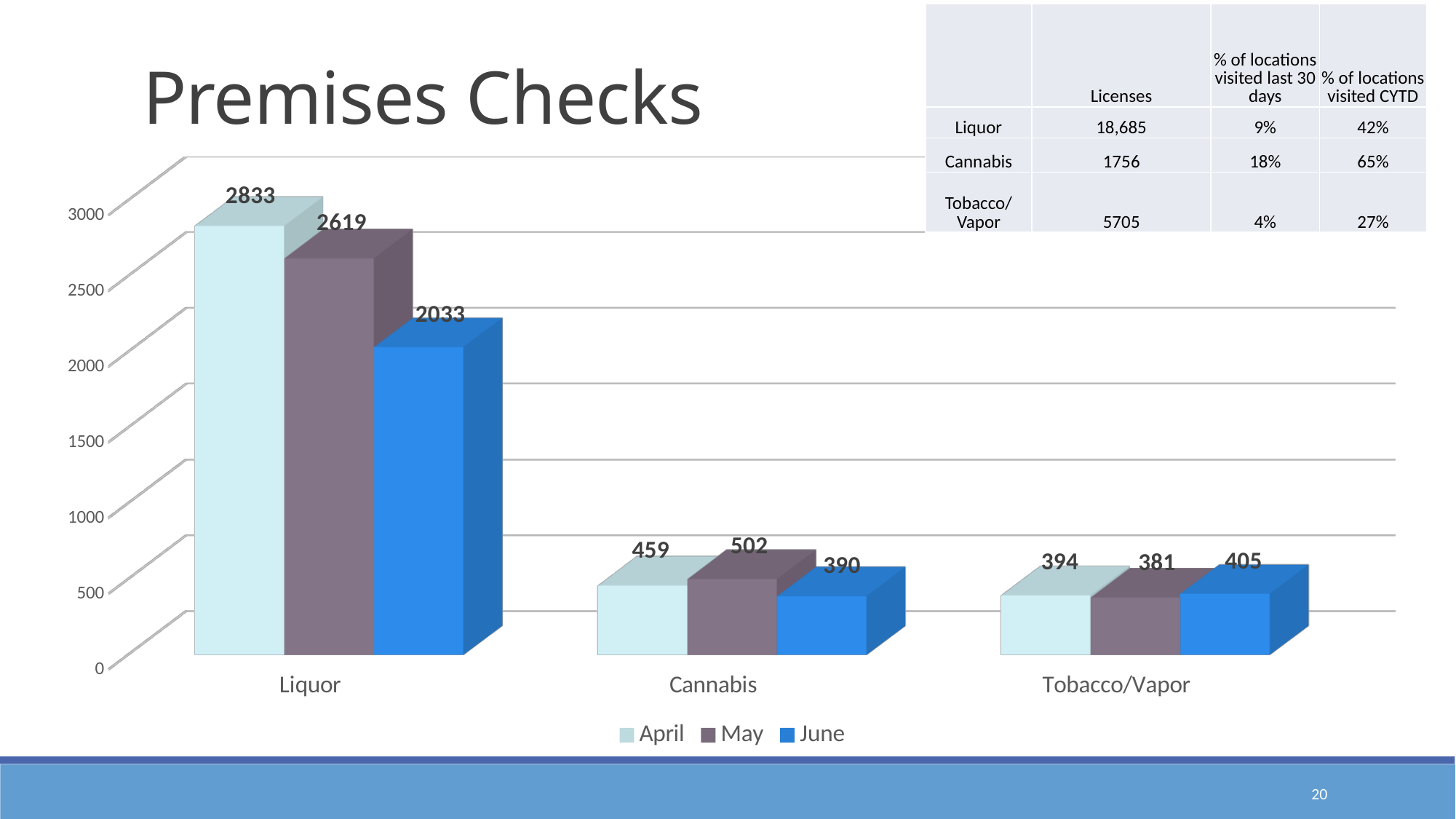
What kind of chart is shown on the slide? Bar chart How many series does the legend list? 3 How many categories are shown on the x axis? 3 Which is larger for Cannabis, the April value or the June value? April Which month has the lowest value for Liquor? June Is the value for Liquor in May greater or less than 2500? greater Which category has the highest value in June? Liquor What is the difference between the April and June values for Liquor? 800 What is the value for Tobacco/Vapor in June? 405 What is the title of the slide containing the chart? Premises Checks What is the value for Cannabis in May? 502 What is the value for Liquor in April? 2833